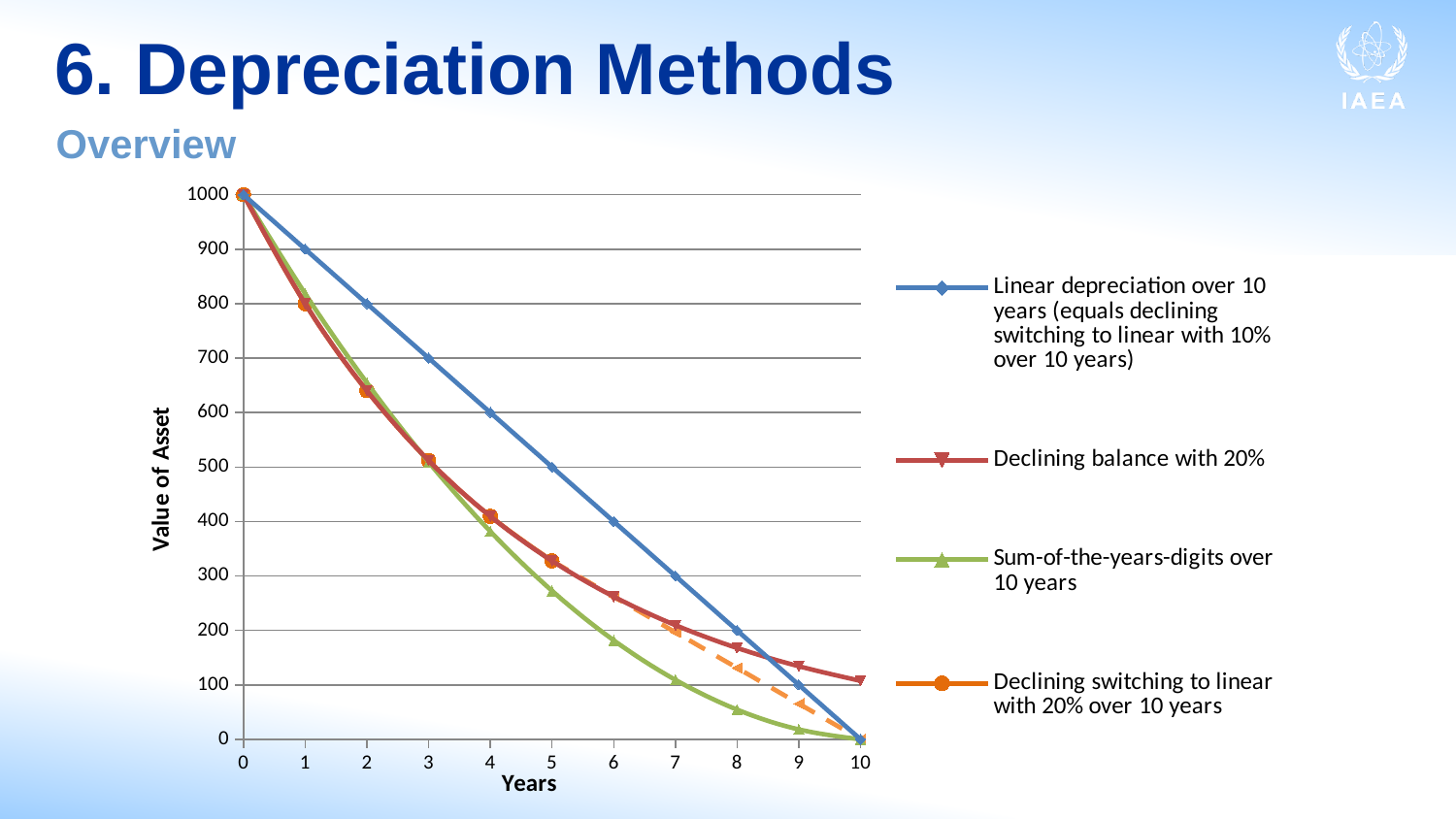
What is the value of asset for the 'Declining balance with 20%' series at year 1? 800 What is the value of asset for the 'Linear depreciation over 10 years' series at year 3? 700 What kind of chart is shown on the slide? line chart At year 5, which series has the larger value: 'Linear depreciation over 10 years' or 'Sum-of-the-years-digits over 10 years'? Linear depreciation over 10 years Is the value for 'Sum-of-the-years-digits over 10 years' at year 8 greater or less than 100? less What is the value of asset for the 'Linear depreciation over 10 years' series at year 5? 500 Do the values of asset rise or fall as the years increase along the x axis? fall Which series has the highest value of asset at year 10? Declining balance with 20% Is the value for 'Declining balance with 20%' at year 5 greater or less than 300? greater How many year points are plotted along the x axis (from 0 to 10)? 11 How many series does the legend list? 4 What is the starting value of asset at year 0 for all series? 1000